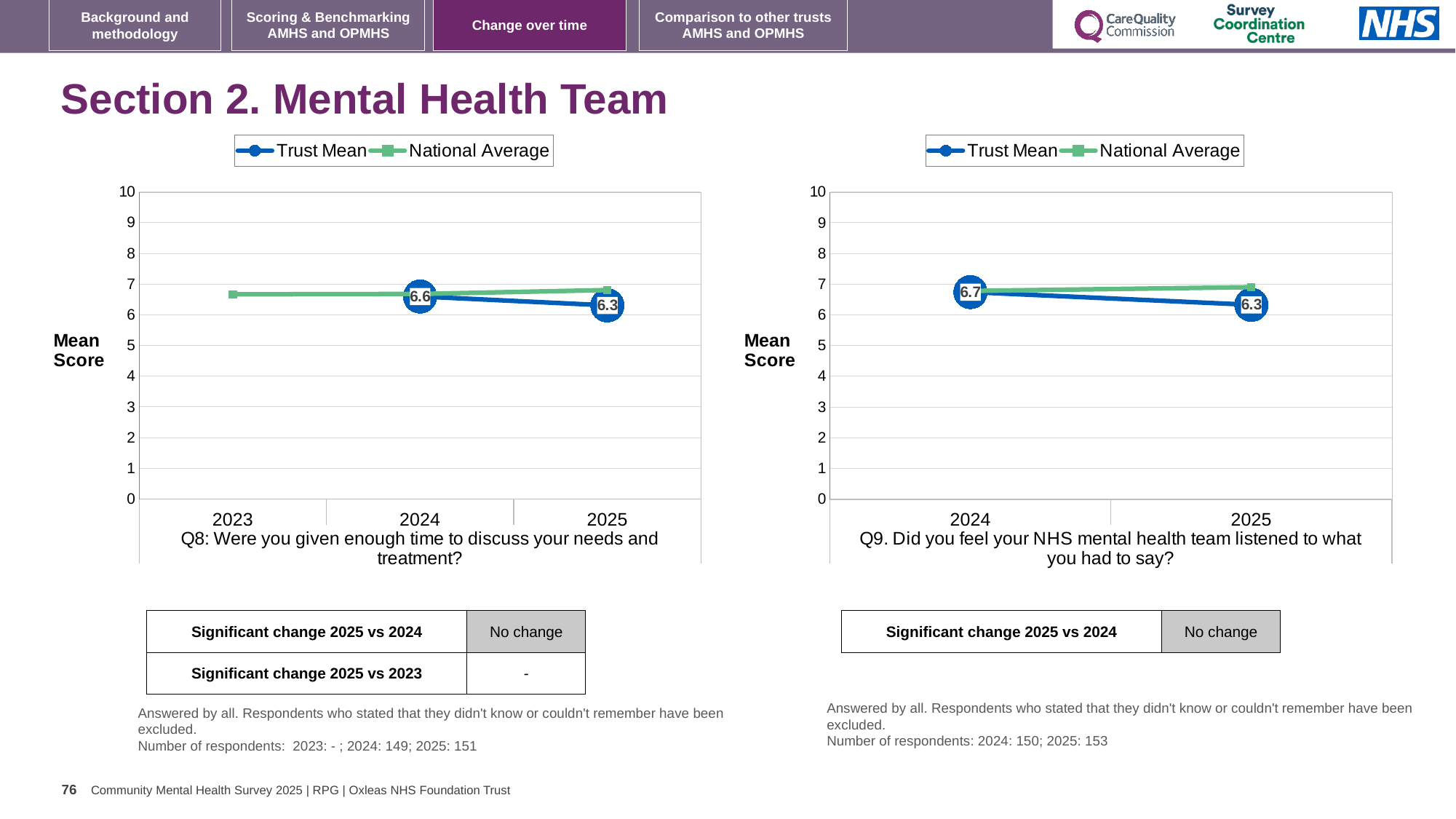
On the right chart (Q9), in 2025 which is larger, the Trust Mean or the National Average? National Average How many years are shown on the x axis of the left chart (Q8)? 3 On the right chart (Q9), does the Trust Mean rise or fall from 2024 to 2025? fall On the right chart (Q9), what is the Trust Mean score for 2025? 6.3 On the left chart (Q8), what is the Trust Mean score for 2025? 6.3 On the left chart (Q8), which year has the larger Trust Mean score, 2024 or 2025? 2024 On the left chart (Q8), what is the Trust Mean score for 2024? 6.6 What type of chart is the right chart (Q9)? line chart On the right chart (Q9), what is the difference between the Trust Mean scores for 2024 and 2025? 0.4 On the left chart (Q8), what is the difference between the Trust Mean scores for 2024 and 2025? 0.3 On the left chart (Q8), is the National Average value for 2025 greater or less than 5? greater On the right chart (Q9), what is the Trust Mean score for 2024? 6.7